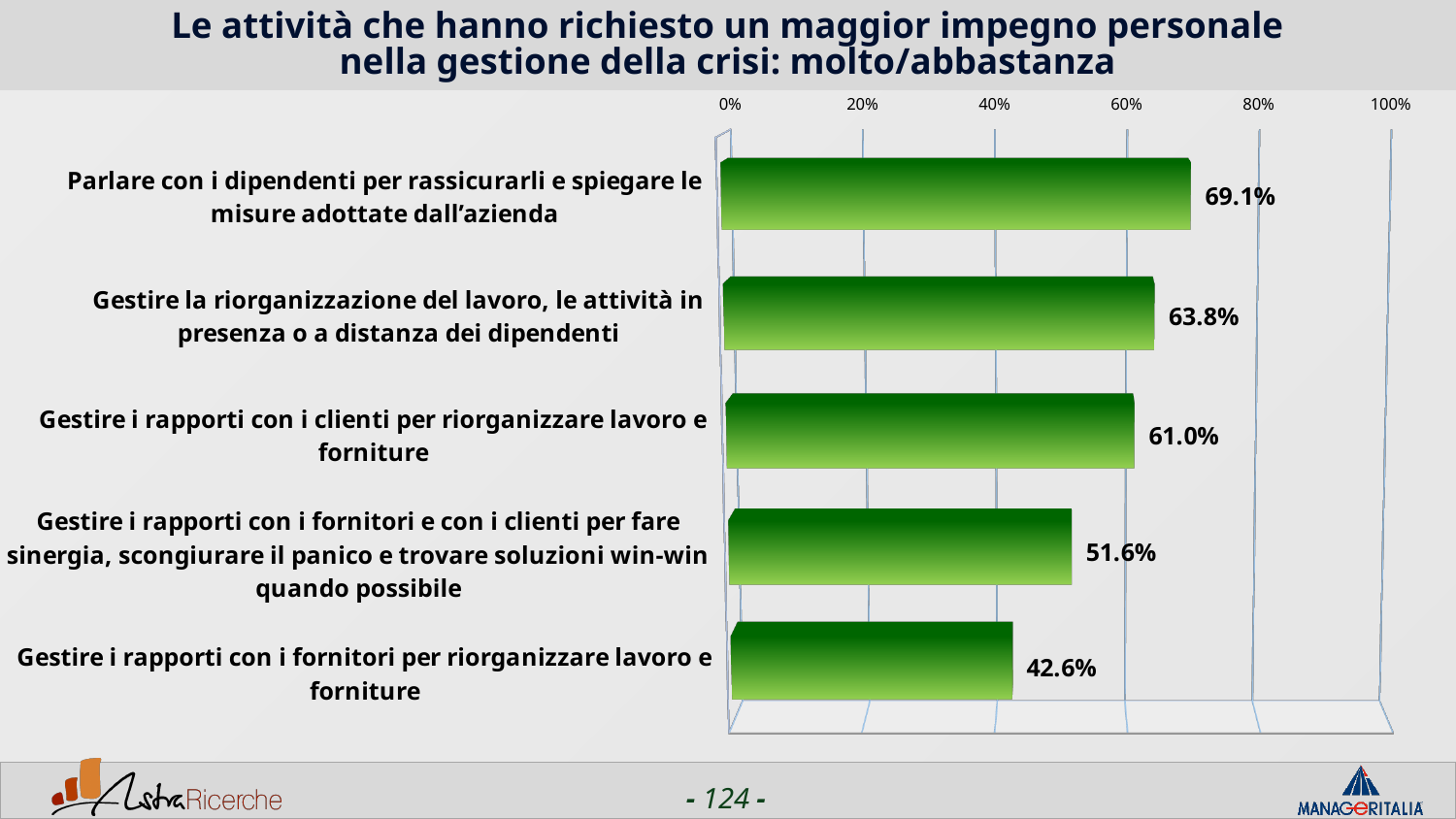
What is the difference between the values for 'Gestire la riorganizzazione del lavoro, le attività in presenza o a distanza dei dipendenti' and 'Gestire i rapporti con i fornitori e con i clienti per fare sinergia, scongiurare il panico e trovare soluzioni win-win quando possibile'? 12.2% What is the value for 'Gestire i rapporti con i clienti per riorganizzare lavoro e forniture'? 61.0% What is the value for 'Parlare con i dipendenti per rassicurarli e spiegare le misure adottate dall'azienda'? 69.1% What is the value for 'Gestire i rapporti con i fornitori per riorganizzare lavoro e forniture'? 42.6% Which activity has the highest value? Parlare con i dipendenti per rassicurarli e spiegare le misure adottate dall'azienda Do the values rise or fall going from the top bar to the bottom bar? Fall Which is larger: the value for 'Gestire la riorganizzazione del lavoro, le attività in presenza o a distanza dei dipendenti' or for 'Gestire i rapporti con i clienti per riorganizzare lavoro e forniture'? Gestire la riorganizzazione del lavoro, le attività in presenza o a distanza dei dipendenti Which activity has the lowest value? Gestire i rapporti con i fornitori per riorganizzare lavoro e forniture How many activities are shown in the chart? 5 What kind of chart is shown on the slide? Bar chart What is the maximum value shown on the horizontal axis? 100% Is the value for 'Gestire i rapporti con i fornitori e con i clienti per fare sinergia, scongiurare il panico e trovare soluzioni win-win quando possibile' greater or less than 60%? less